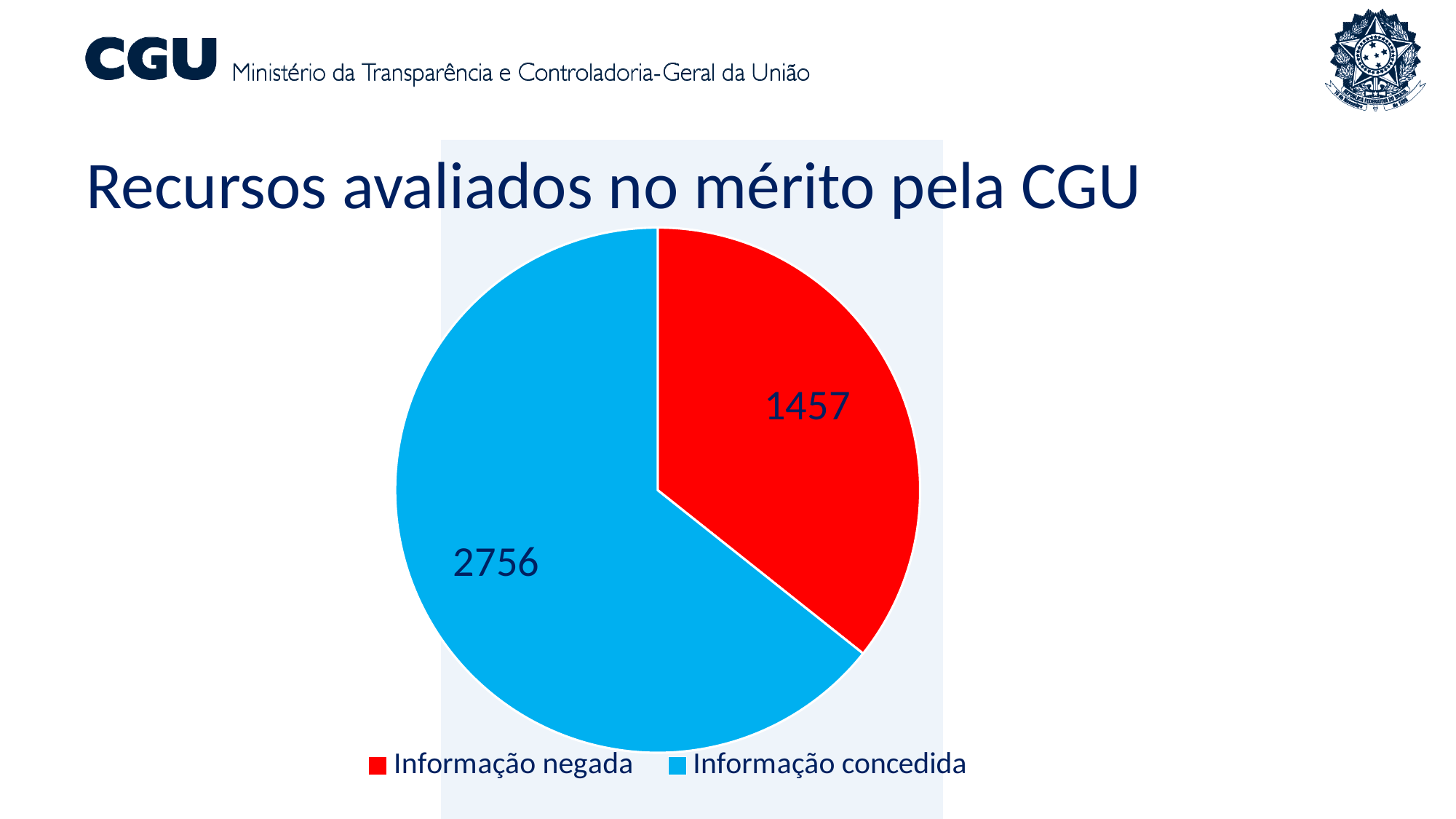
How many slices does the pie chart have? 2 What is the total of the two slices in the pie chart? 4213 What is the difference between the values for Informação concedida and Informação negada? 1299 What value is shown for Informação concedida? 2756 Which is larger, Informação negada or Informação concedida? Informação concedida How many entries does the legend list? 2 What is the title of the chart? Recursos avaliados no mérito pela CGU Which slice of the pie is the largest? Informação concedida What value is shown for Informação negada? 1457 Which slice of the pie is the smallest? Informação negada What kind of chart is shown on the slide? Pie chart